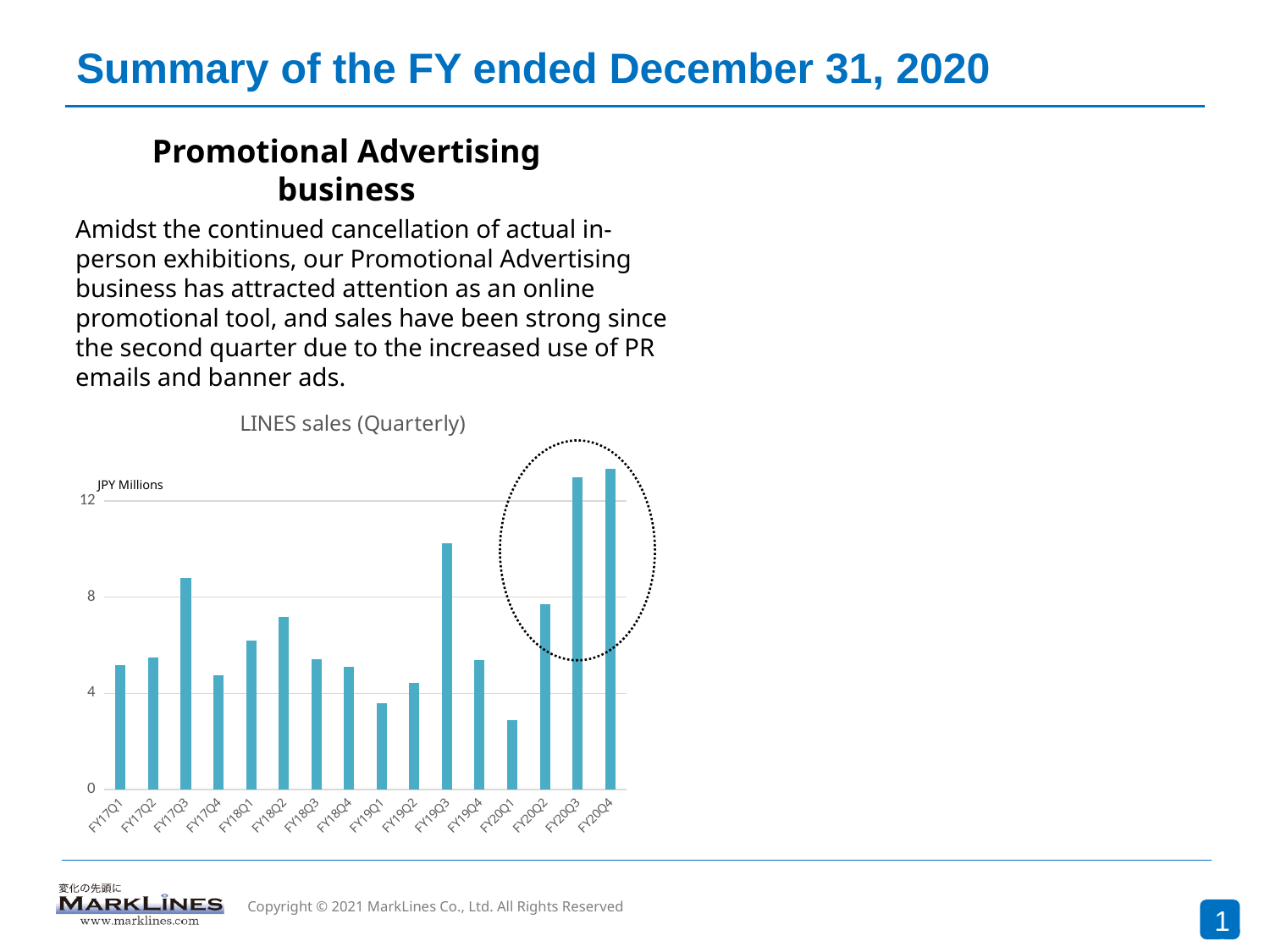
Is the value for FY20Q3 greater or less than 12? greater Which is larger, the value for FY19Q3 or the value for FY18Q2? FY19Q3 Is the value for FY18Q2 greater or less than 8? less Which is larger, the value for FY19Q1 or the value for FY20Q1? FY19Q1 What unit is shown on the chart's vertical axis? JPY Millions Which is larger, the value for FY17Q3 or the value for FY17Q4? FY17Q3 Is the value for FY19Q1 greater or less than 4? less What is the title of the chart? LINES sales (Quarterly) What kind of chart is shown on the slide? Bar chart How many quarters are plotted on the chart? 16 Which quarter has the lowest LINES sales? FY20Q1